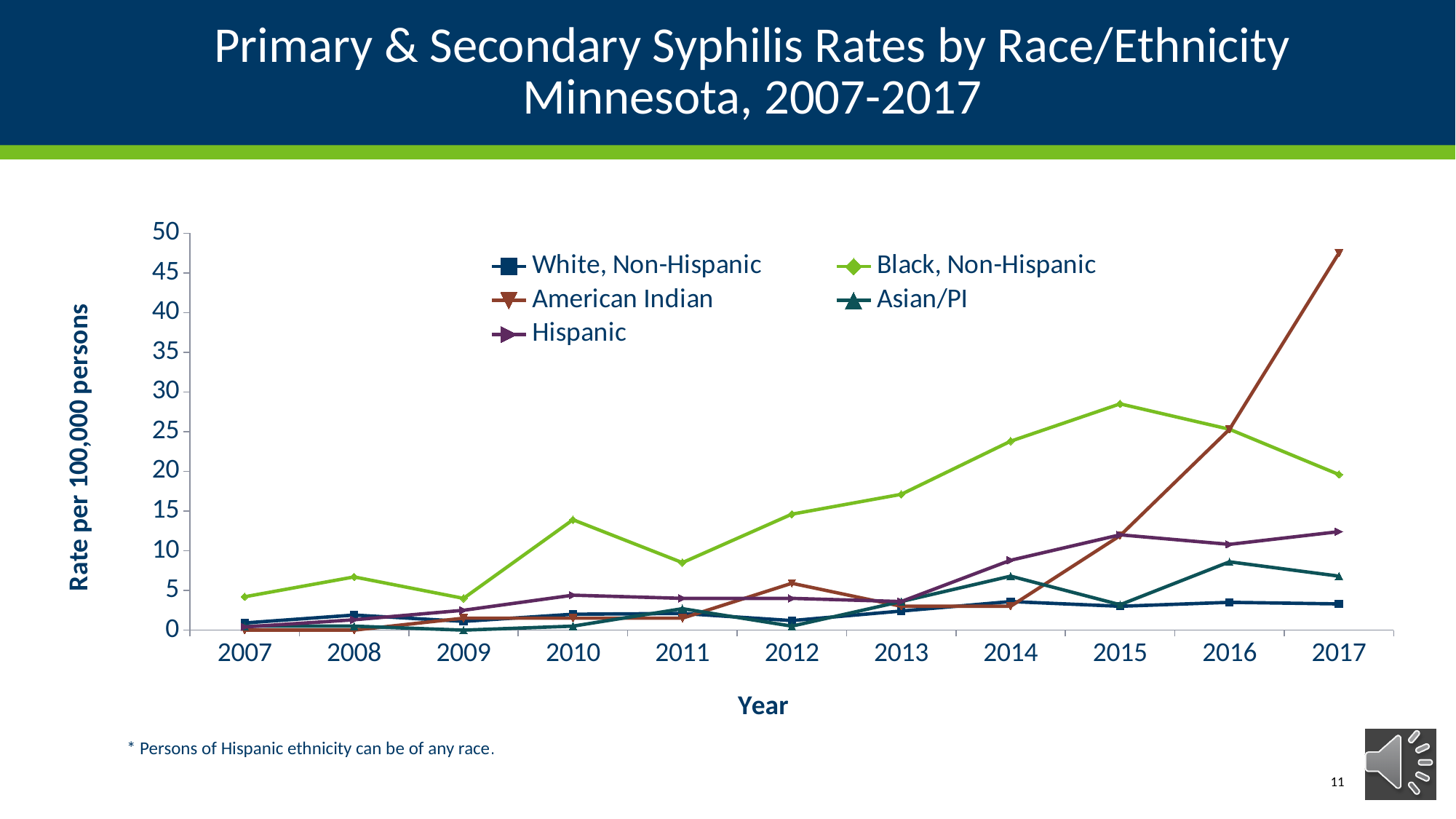
What is the label on the y axis? Rate per 100,000 persons Is the Hispanic rate in 2017 greater or less than 10? greater Is the American Indian rate in 2017 greater or less than 40? greater Which race/ethnicity group has the highest rate in 2017? American Indian What kind of chart is shown on the slide? line chart How many years are plotted along the x axis? 11 How many series does the legend list? 5 Is the Black, Non-Hispanic rate in 2015 greater or less than 25? greater In 2016, which is higher: the Black, Non-Hispanic rate or the Hispanic rate? Black, Non-Hispanic In which year does the Black, Non-Hispanic rate reach its peak? 2015 Does the American Indian rate rise or fall from 2014 to 2017? rise Which group has the lowest rate in 2009? Asian/PI